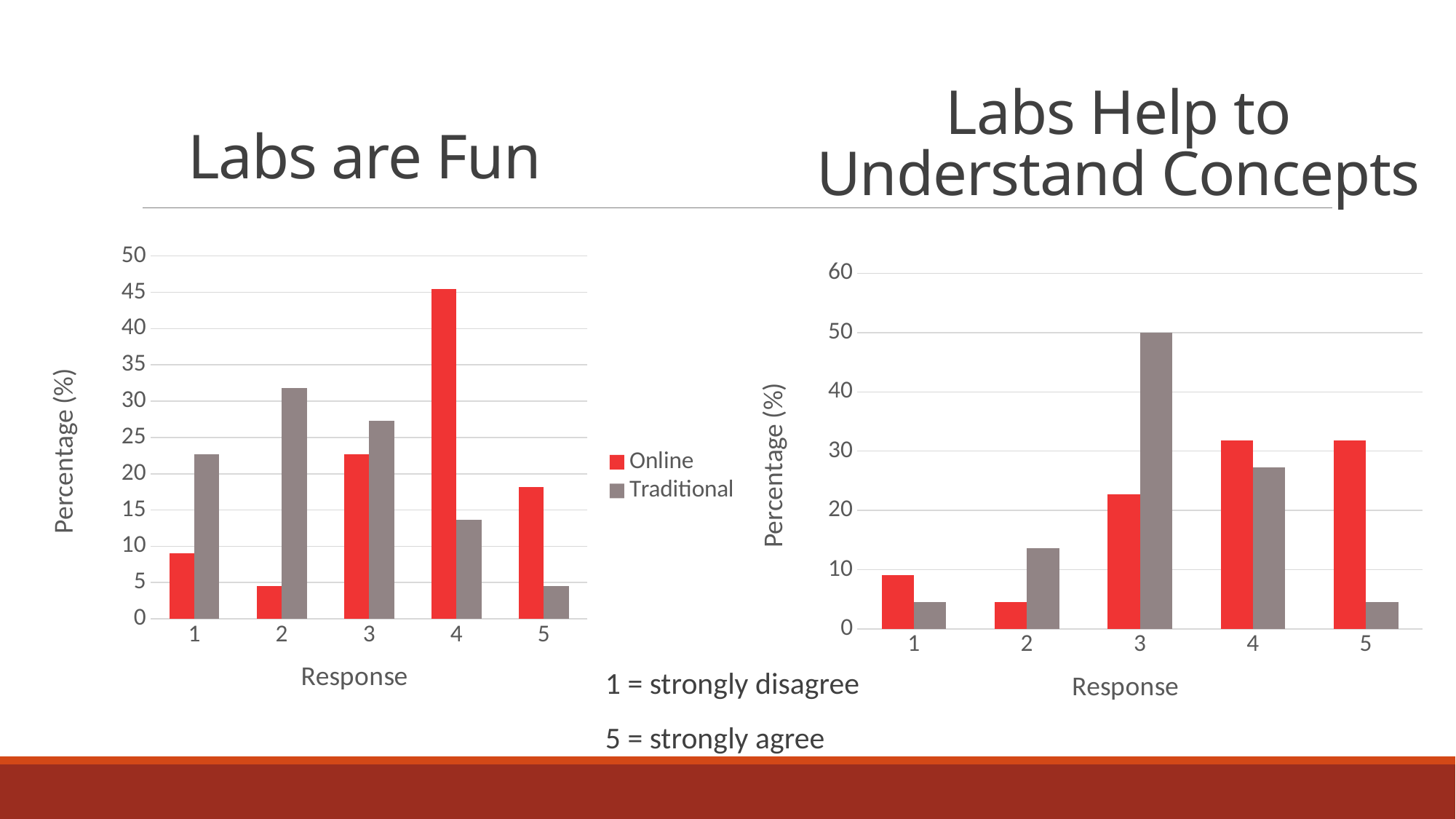
In the "Labs are Fun" chart, which response has the lowest Traditional percentage? 5 In the "Labs are Fun" chart, which response has the highest Online percentage? 4 In the "Labs Help to Understand Concepts" chart, is the Traditional value for response 2 greater or less than 10? greater How many response categories are shown on the x axis of the "Labs Help to Understand Concepts" chart? 5 How many series does the legend list for the "Labs are Fun" chart? 2 In the "Labs are Fun" chart, is the Online value for response 4 greater or less than 40? greater In the "Labs Help to Understand Concepts" chart, what is the Traditional percentage for response 3? 50 What kind of chart is the "Labs are Fun" chart? bar chart In the "Labs are Fun" chart, for response 2, which series has the larger value, Online or Traditional? Traditional In the "Labs Help to Understand Concepts" chart, what colour represents the Online series? red In the "Labs Help to Understand Concepts" chart, which response has the highest Traditional percentage? 3 In the "Labs are Fun" chart, which response has the highest Traditional percentage? 2